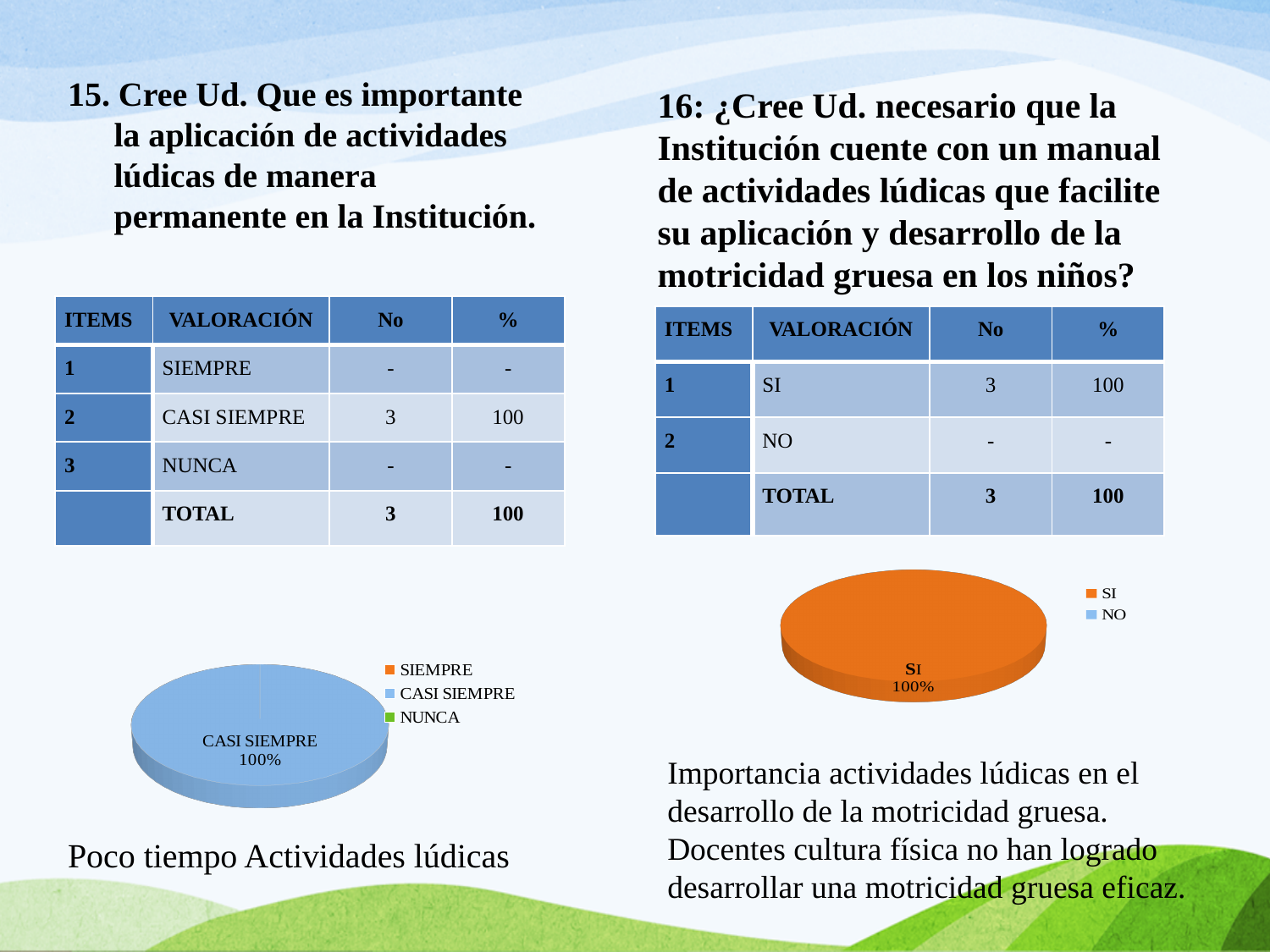
In the right pie chart, is the share for SI greater or less than 50%? greater How many entries does the legend of the right pie chart list? 2 In the right pie chart, which category makes up the whole pie? SI In the left pie chart, what share is labelled for CASI SIEMPRE? 100% What kind of chart is shown on the left side of the slide? pie chart What kind of chart is shown on the right side of the slide? pie chart In the left pie chart, which category makes up the whole pie? CASI SIEMPRE How many entries does the legend of the left pie chart list? 3 In the left pie chart, which is larger, the share for CASI SIEMPRE or the share for NUNCA? CASI SIEMPRE In the right pie chart, what share is labelled for SI? 100% What colour is the SI slice in the right pie chart? orange What are the legend entries of the left pie chart? SIEMPRE, CASI SIEMPRE, NUNCA